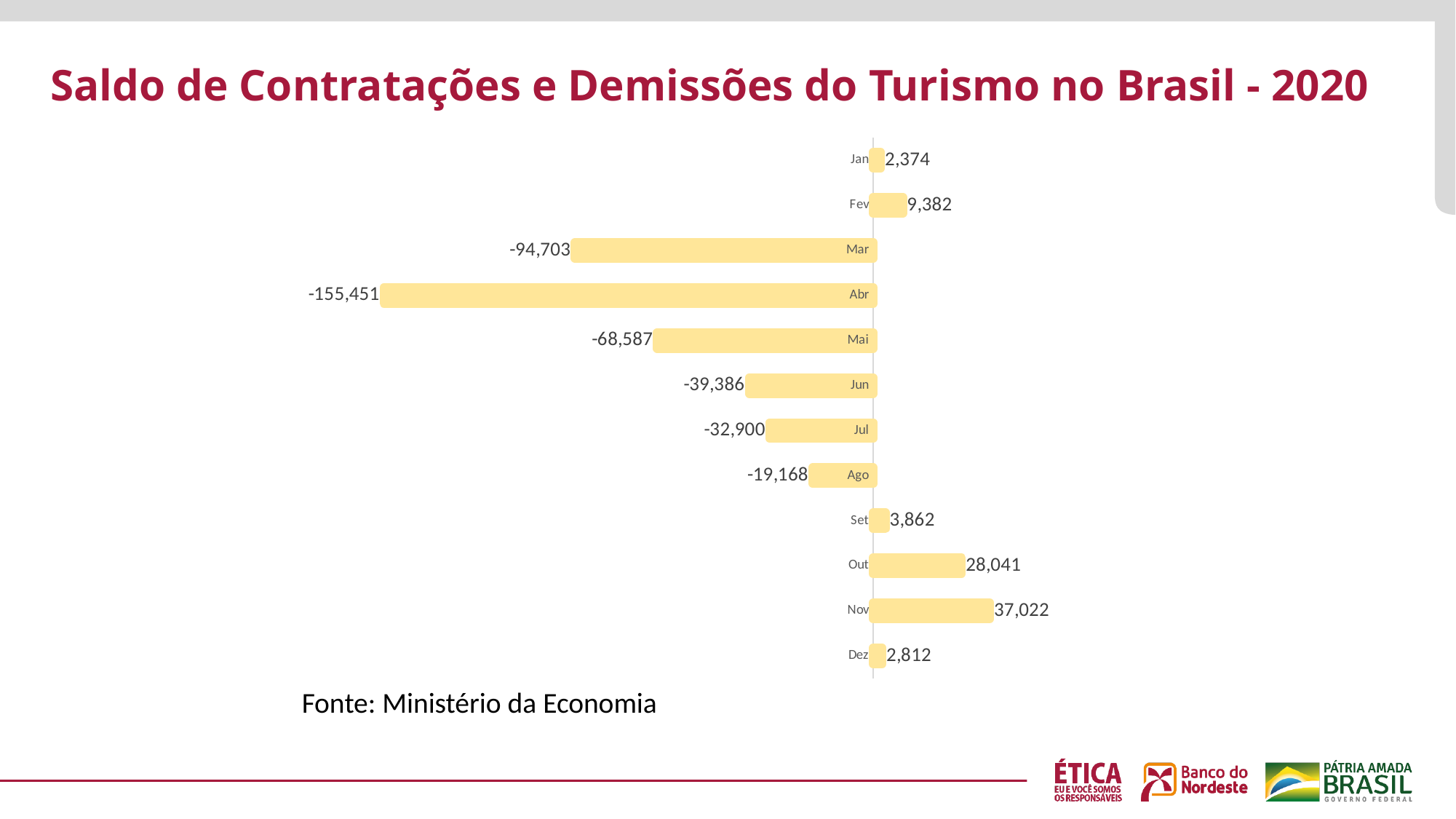
What is the difference between the values for Nov and Out? 8,981 What is the value for Ago? -19,168 What is the title of the chart? Saldo de Contratações e Demissões do Turismo no Brasil - 2020 What is the difference between the values for Mar and Abr? 60,748 Which month has the lowest value? Abr What is the value for Nov? 37,022 Which month has the highest value? Nov What kind of chart is shown on the slide? Bar chart Do the values rise or fall from Abr to Ago? Rise Which is larger, the value for Jan or the value for Dez? Dez What is the value for Abr? -155,451 How many months are shown in the chart? 12